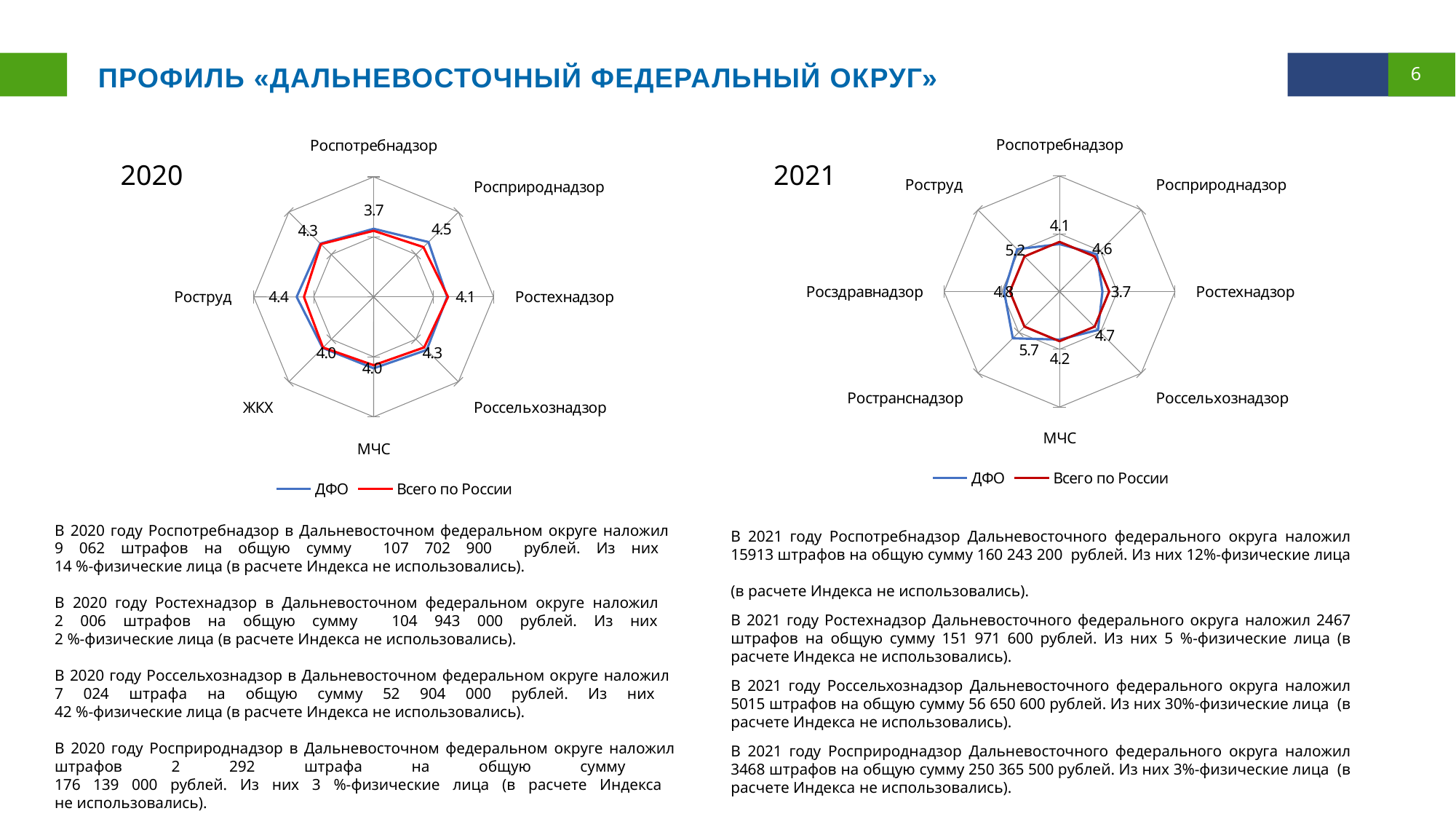
In the 2020 chart, which labelled value is larger: Росприроднадзор or Роспотребнадзор? Росприроднадзор In the 2020 chart, what value is labelled on the Росприроднадзор axis? 4.5 In the 2021 chart, what value is labelled on the Ространснадзор axis? 5.7 In the 2021 chart, which category has the highest labelled value? Ространснадзор How many series does the legend of the 2021 chart list? 2 In the 2021 chart, what value is labelled on the Роструд axis? 5.2 In the 2021 chart, which category has the lowest labelled value? Ростехнадзор How many categories (axes) does the 2021 radar chart have? 8 In the 2021 chart, what is the difference between the labelled values for Ространснадзор and Ростехнадзор? 2.0 In the 2020 chart, what value is labelled on the Ростехнадзор axis? 4.1 What are the two legend entries of the 2020 chart? ДФО and Всего по России What kind of chart is the 2020 chart on the left? Radar chart